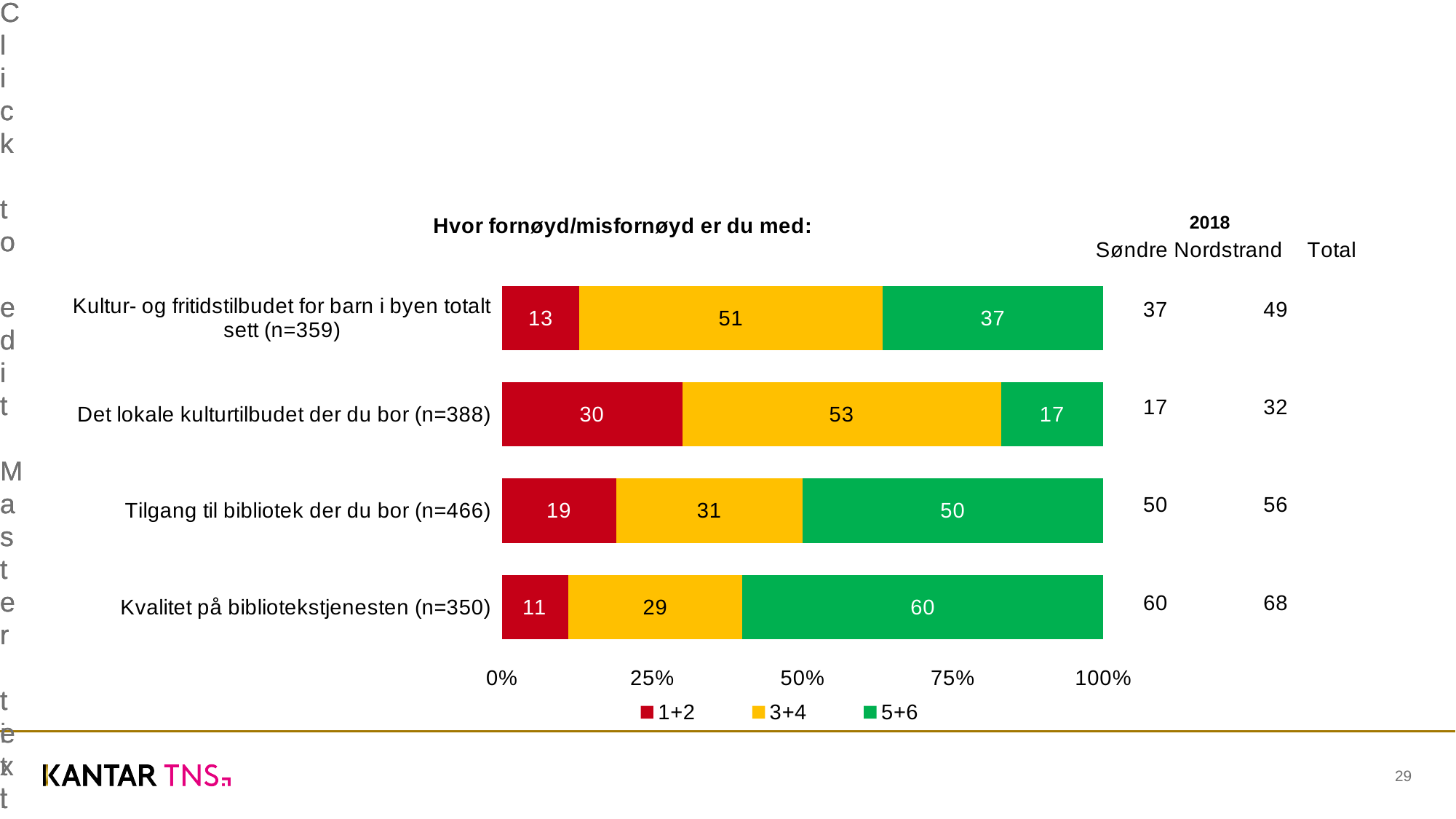
What is the 1+2 value for "Det lokale kulturtilbudet der du bor (n=388)"? 30 What is the title of the chart? Hvor fornøyd/misfornøyd er du med: What kind of chart is shown on the slide? Stacked bar chart How many categories are plotted in the chart? 4 Which category has the highest 5+6 value? Kvalitet på bibliotekstjenesten (n=350) What is the difference between the 3+4 values for "Det lokale kulturtilbudet der du bor (n=388)" and "Tilgang til bibliotek der du bor (n=466)"? 22 What is the 5+6 value for "Kvalitet på bibliotekstjenesten (n=350)"? 60 Which is larger: the 5+6 value for "Kultur- og fritidstilbudet for barn i byen totalt sett (n=359)" or for "Det lokale kulturtilbudet der du bor (n=388)"? Kultur- og fritidstilbudet for barn i byen totalt sett (n=359) What is the 3+4 value for "Tilgang til bibliotek der du bor (n=466)"? 31 How many series does the legend list? 3 Which colour represents the 1+2 series in the chart? Red Which category has the lowest 1+2 value? Kvalitet på bibliotekstjenesten (n=350)